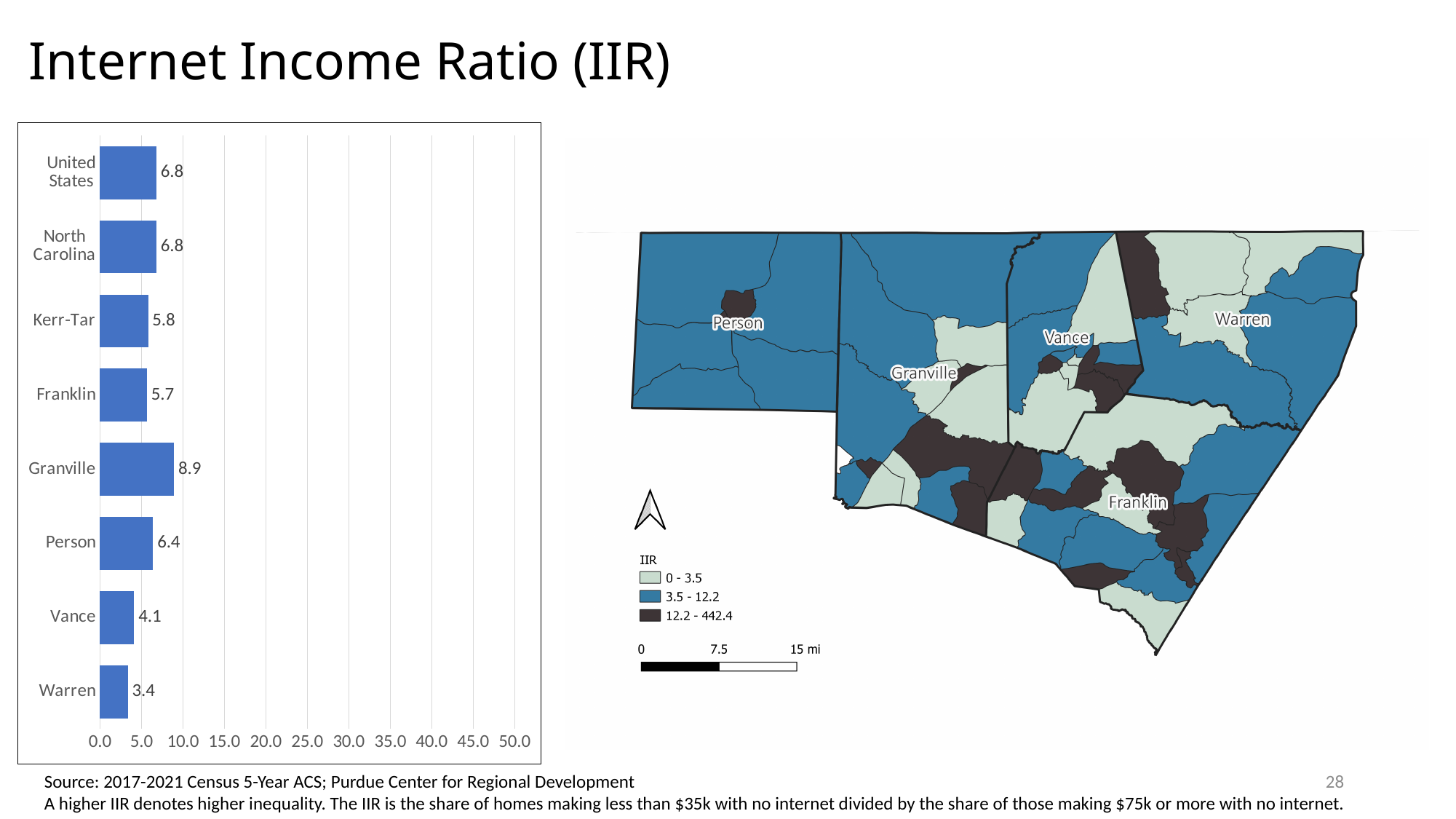
What is the difference between the values for Granville and Warren in the bar chart? 5.5 What is the Internet Income Ratio value for Granville in the bar chart? 8.9 Which category has the highest value in the bar chart? Granville What is the Internet Income Ratio value for Kerr-Tar in the bar chart? 5.8 Which category has the lowest value in the bar chart? Warren Which has a larger value in the bar chart, Franklin or Person? Person What is the difference between the values for Person and Vance in the bar chart? 2.3 How many categories are shown in the bar chart? 8 What kind of chart is shown on the left of the slide? Bar chart What is the highest value shown on the x axis of the bar chart? 50.0 What is the Internet Income Ratio value for Vance in the bar chart? 4.1 What is the Internet Income Ratio value for Warren in the bar chart? 3.4